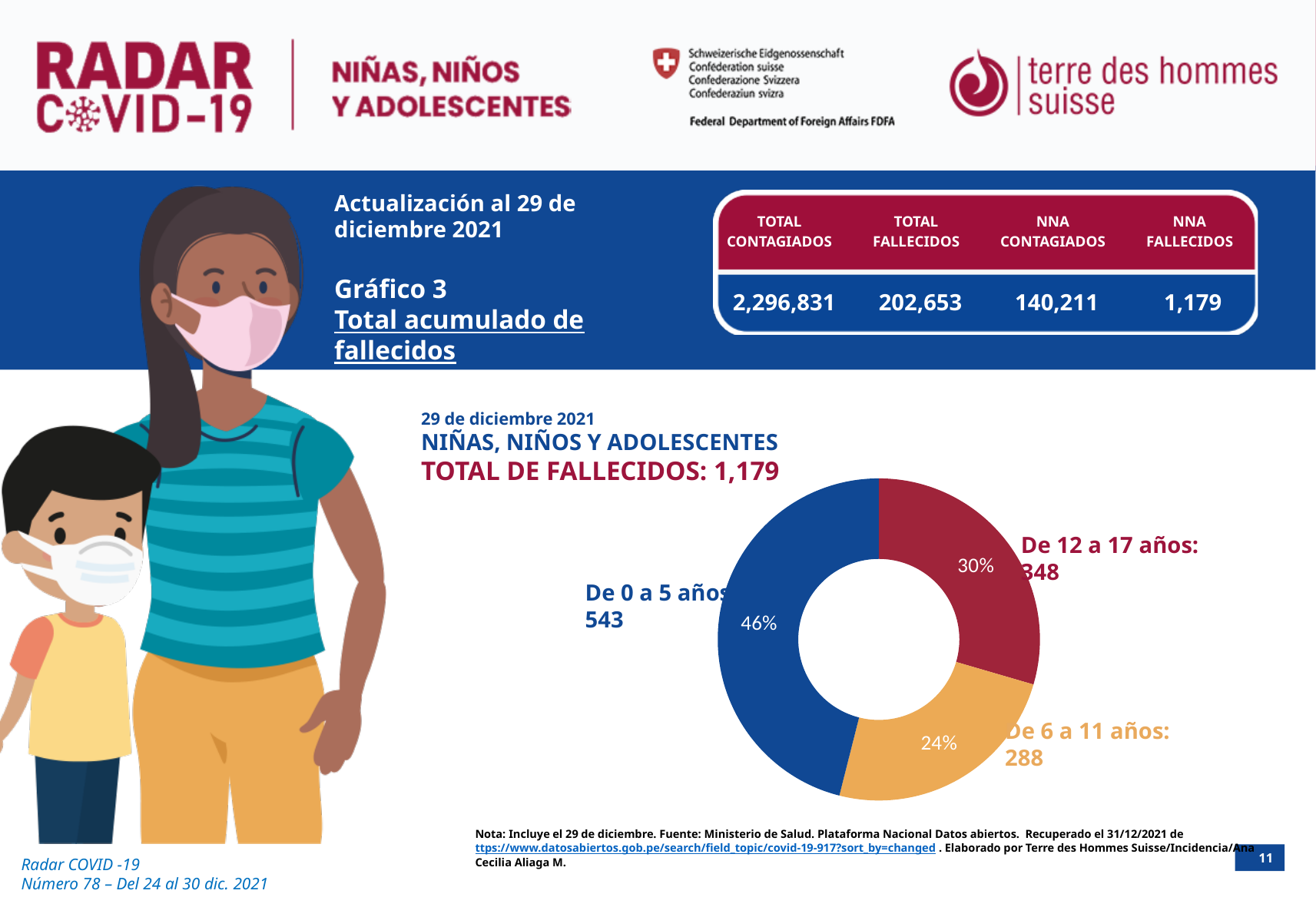
What is the total number of deaths shown in the chart title? 1,179 What is the number of deaths for the 'De 0 a 5 años' group? 543 What is the difference in deaths between 'De 0 a 5 años' and 'De 6 a 11 años'? 255 Which age group has the highest number of deaths? De 0 a 5 años How many age groups are shown in the donut chart? 3 What percentage of the donut chart corresponds to 'De 12 a 17 años'? 30% Which age group has the lowest number of deaths? De 6 a 11 años Which group has more deaths, 'De 12 a 17 años' or 'De 6 a 11 años'? De 12 a 17 años What is the number of deaths for the 'De 6 a 11 años' group? 288 What percentage of the donut chart corresponds to 'De 0 a 5 años'? 46% What type of chart is shown on the slide? Pie chart (donut) What colour is the slice for 'De 6 a 11 años'? Orange